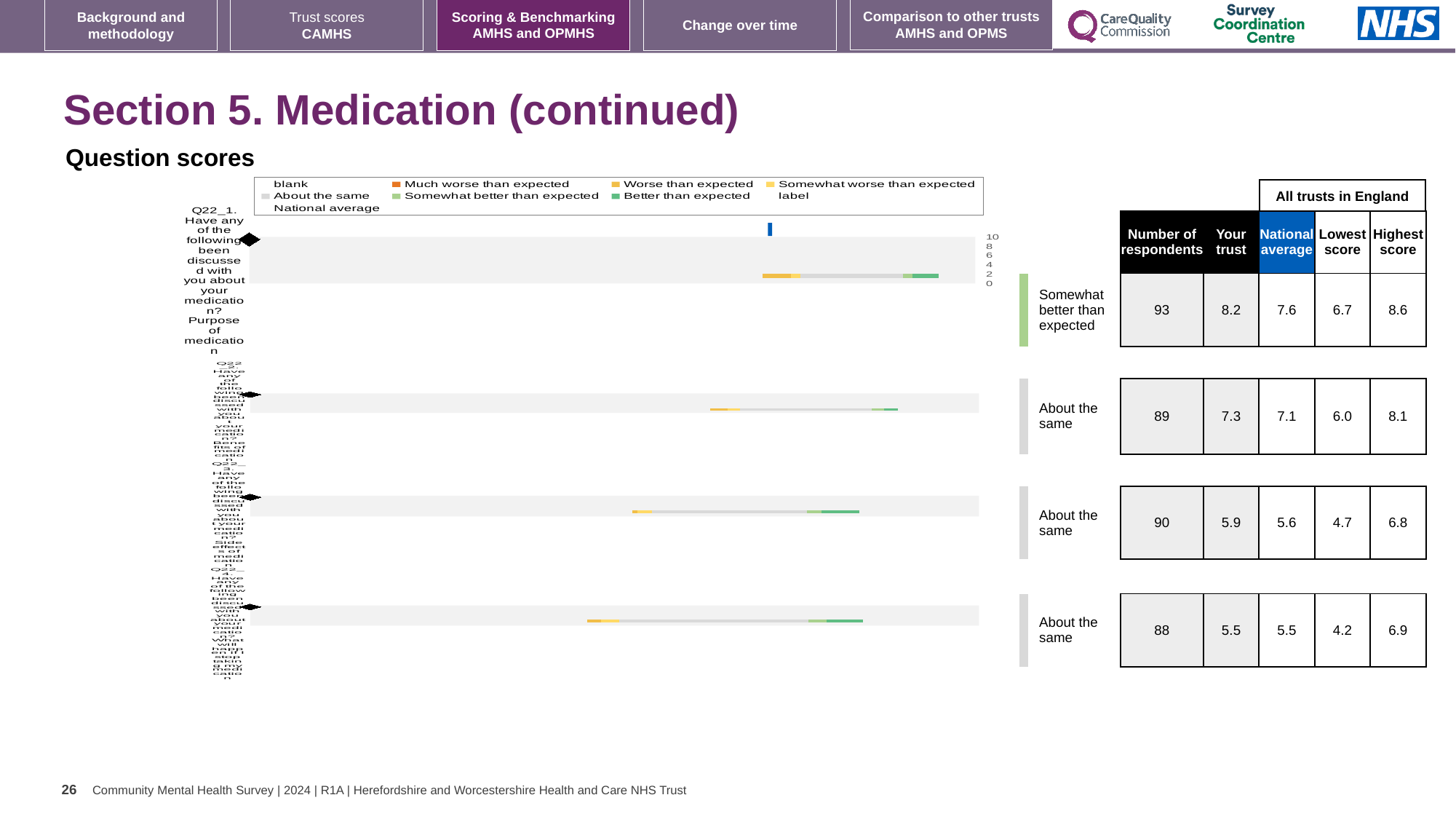
How many question bars (Q22_1 to Q22_4) are plotted in the chart? 4 In the table beside the chart, what is the national average for the first question (Q22_1)? 7.6 In the table beside the chart, how many respondents answered the second question (Q22_2)? 89 What is the highest tick value shown on the chart's score axis? 10 In the table beside the chart, is the 'Your trust' score for the third question (Q22_3) higher or lower than its national average? higher In the table beside the chart, which question row has the lowest 'Your trust' score? Q22_4 (5.5) In the table beside the chart, what is the difference between the 'Your trust' score and the national average for the first question (Q22_1)? 0.6 Which legend entry in the chart is shown in dark green? Better than expected In the table beside the chart, what is the highest score across all trusts in England for the fourth question (Q22_4)? 6.9 In the table beside the chart, which question row has the highest 'Your trust' score? Q22_1 (8.2) What kind of chart is shown under 'Question scores'? bar chart In the table beside the chart, what is the 'Your trust' score for the first question (Q22_1, purpose of medication)? 8.2